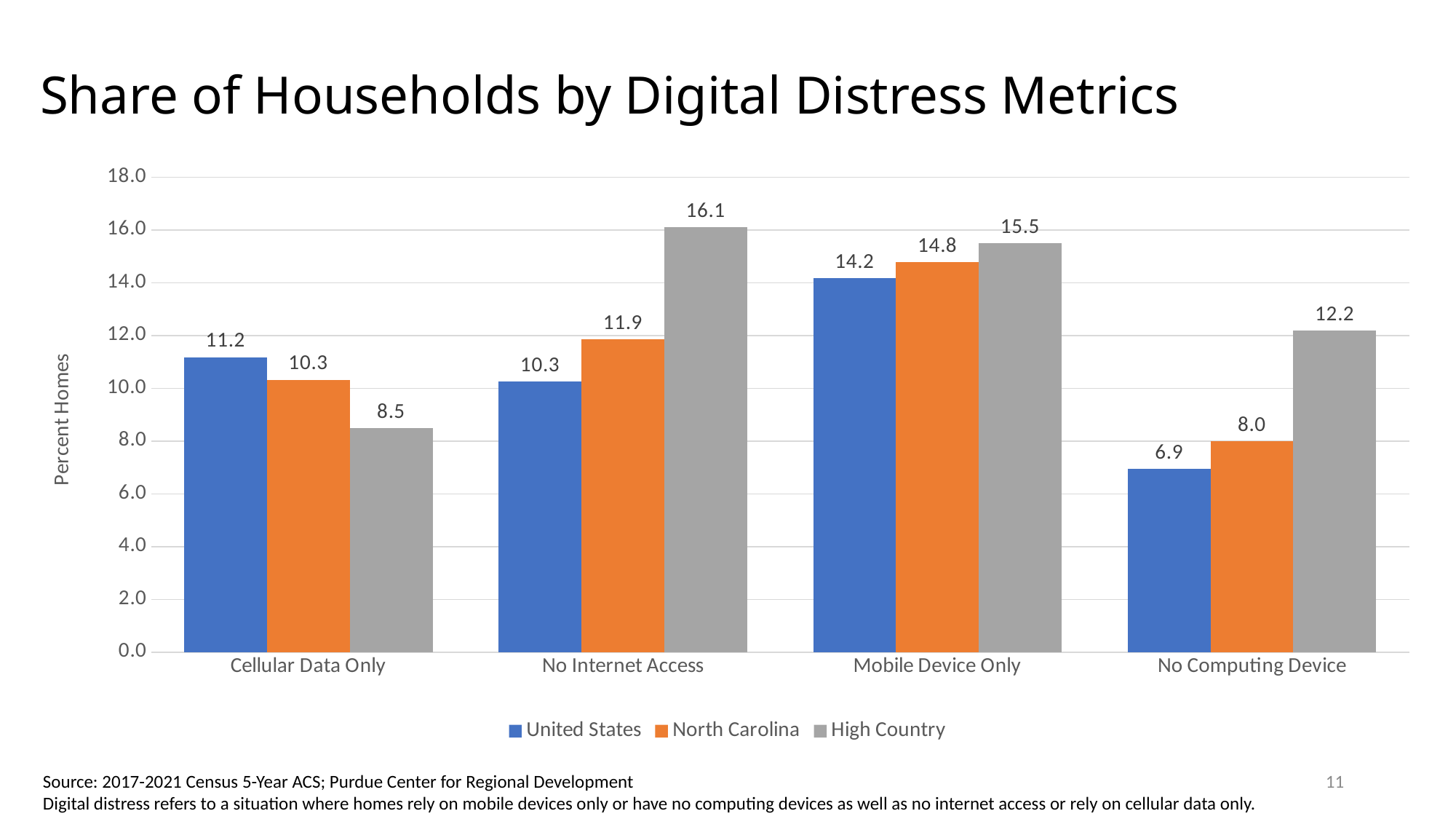
How many series does the legend list? 3 What is the value for High Country in the No Internet Access category? 16.1 What is the difference between the High Country and United States values in the No Computing Device category? 5.3 In the Cellular Data Only category, which is larger: United States or High Country? United States Which category has the highest value for High Country? No Internet Access What is the value for United States in the No Computing Device category? 6.9 How many categories are shown on the x axis? 4 What is the value for North Carolina in the Mobile Device Only category? 14.8 Is the value for North Carolina in the No Internet Access category greater or less than 10.0? greater What kind of chart is shown on the slide? bar chart Which category has the lowest value for United States? No Computing Device What is the label of the y axis? Percent Homes